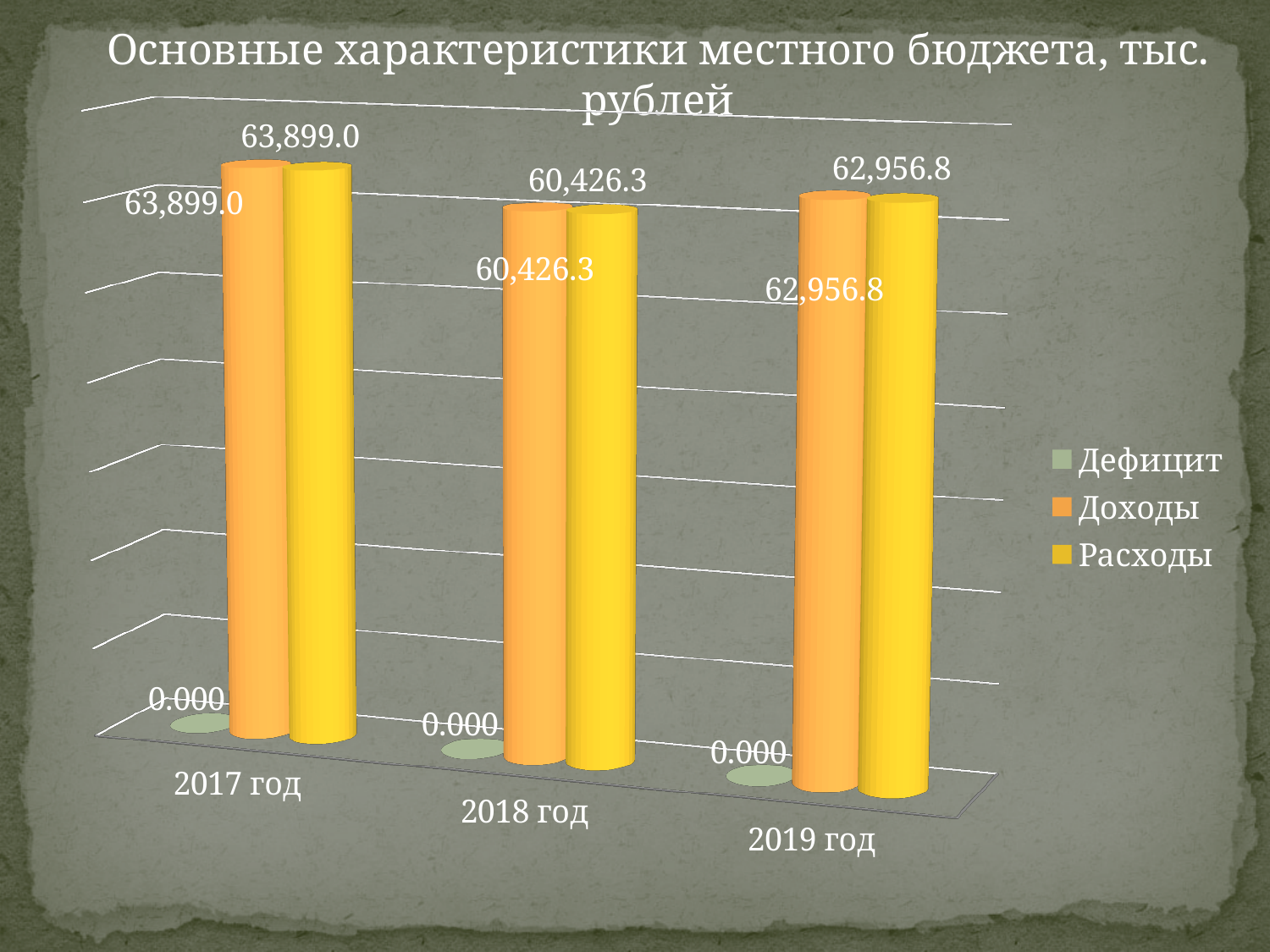
What is the value of Доходы for 2017 год? 63,899.0 How many years are shown on the x axis? 3 In which year is Расходы the lowest? 2018 год What is the difference between Доходы in 2017 год and Доходы in 2018 год? 3,472.7 What kind of chart is shown on the slide? Bar chart In which year is Доходы the highest? 2017 год What is the difference between Расходы in 2019 год and Расходы in 2018 год? 2,530.5 Which is larger: Доходы in 2017 год or Доходы in 2019 год? Доходы in 2017 год What is the value of Дефицит for 2018 год? 0.000 How many series does the legend list? 3 What is the value of Доходы for 2019 год? 62,956.8 What is the value of Расходы for 2018 год? 60,426.3